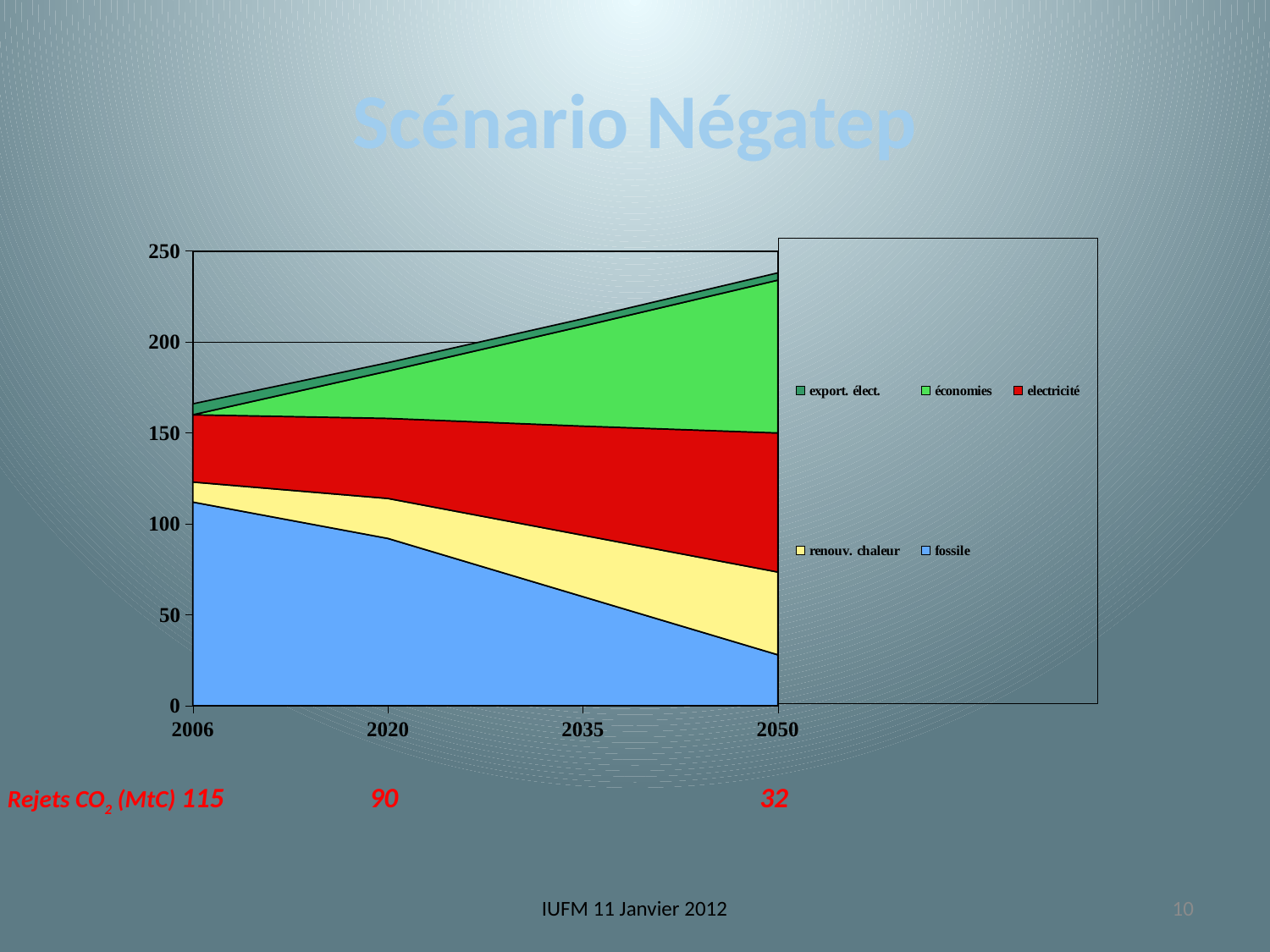
Is the value for fossile in 2050 greater or less than 50? less Is the total stacked value in 2050 greater or less than 200? greater Is the value for fossile in 2006 greater or less than 100? greater Which year has the lowest total stacked value? 2006 What is the title of the slide containing the chart? Scénario Négatep What kind of chart is shown on the slide? area chart How many years are labelled on the x axis? 4 Which year has the highest total stacked value? 2050 How many series does the legend list? 5 Does the fossile series rise or fall from 2006 to 2050? fall Does the économies series rise or fall from 2006 to 2050? rise